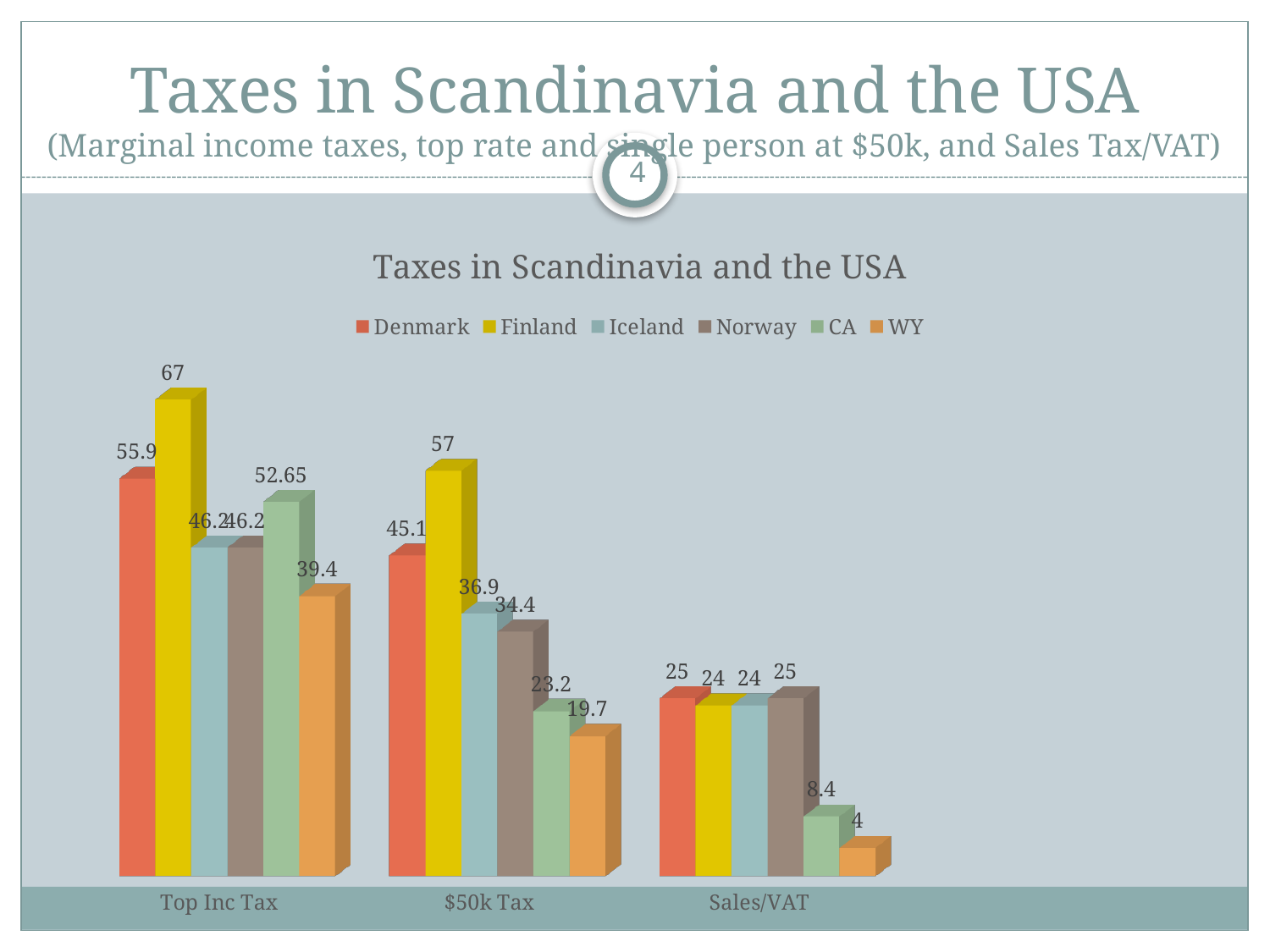
What is the value for WY in the Sales/VAT category? 4 Which series has the highest value in the $50k Tax category? Finland What kind of chart is shown on the slide? Bar chart How many series does the legend list? 6 Which is larger in the $50k Tax category: Iceland or Norway? Iceland What is the value for Finland in the Top Inc Tax category? 67 What is the value for Norway in the $50k Tax category? 34.4 What is the difference between Finland and Denmark in the Top Inc Tax category? 11.1 What is the value for CA in the $50k Tax category? 23.2 How many categories are shown on the x axis? 3 Which series has the lowest value in the Sales/VAT category? WY What is the title of the chart? Taxes in Scandinavia and the USA